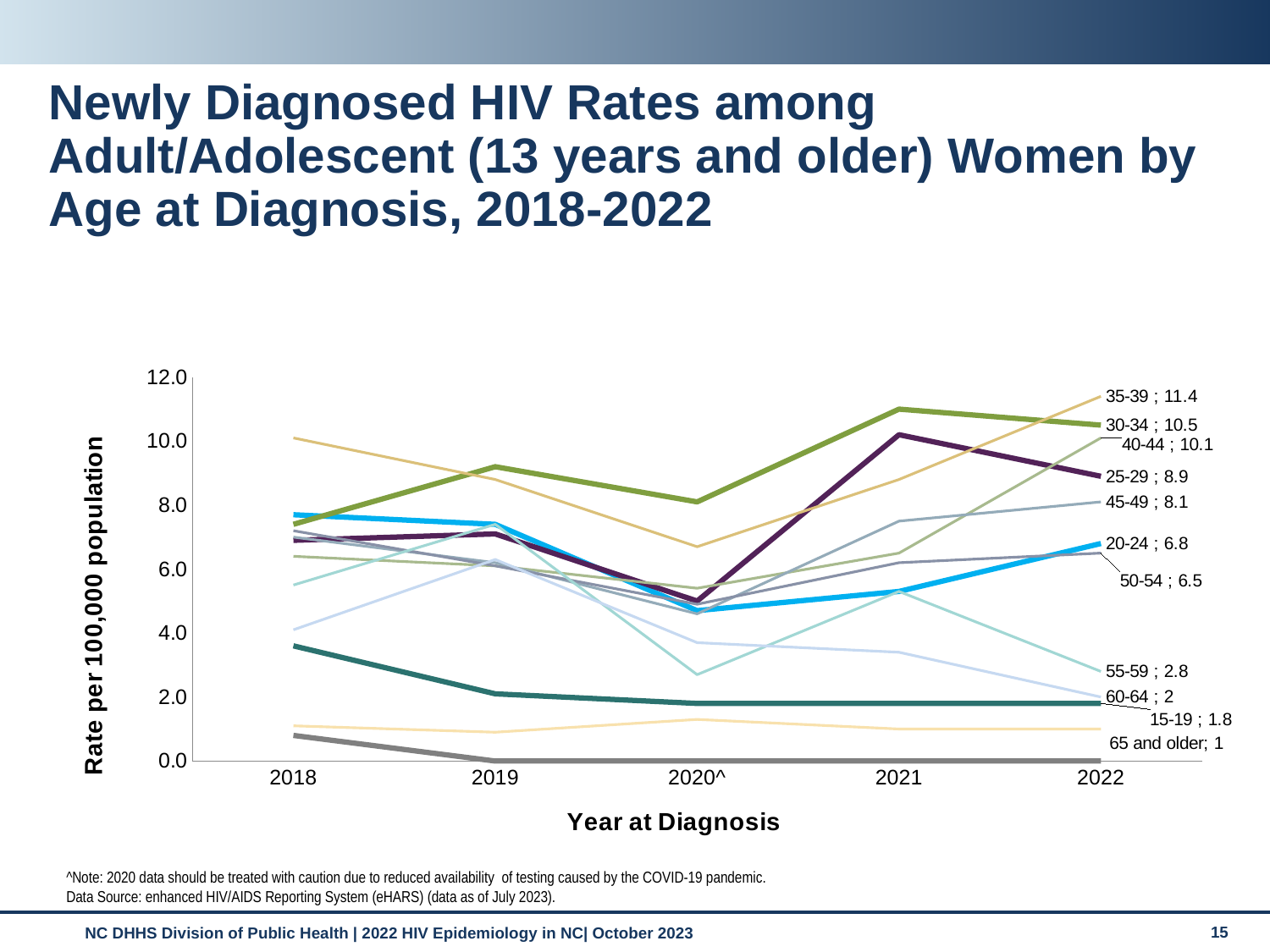
What is the 2022 rate for the 65 and older age group? 1 What is the 2022 rate for the 50-54 age group? 6.5 What is the difference between the 2022 rates for the 35-39 and 25-29 age groups? 2.5 What kind of chart is shown on the slide? Line chart What is the 2022 rate for the 35-39 age group? 11.4 In 2022, which age group has a higher rate: 40-44 or 45-49? 40-44 What is the label of the y axis? Rate per 100,000 population Which age group has the highest rate in 2022? 35-39 How many years are shown on the x axis? 5 What is the 2022 rate for the 30-34 age group? 10.5 Is the 2018 rate for the 40-44 age group greater or less than 10.0? less